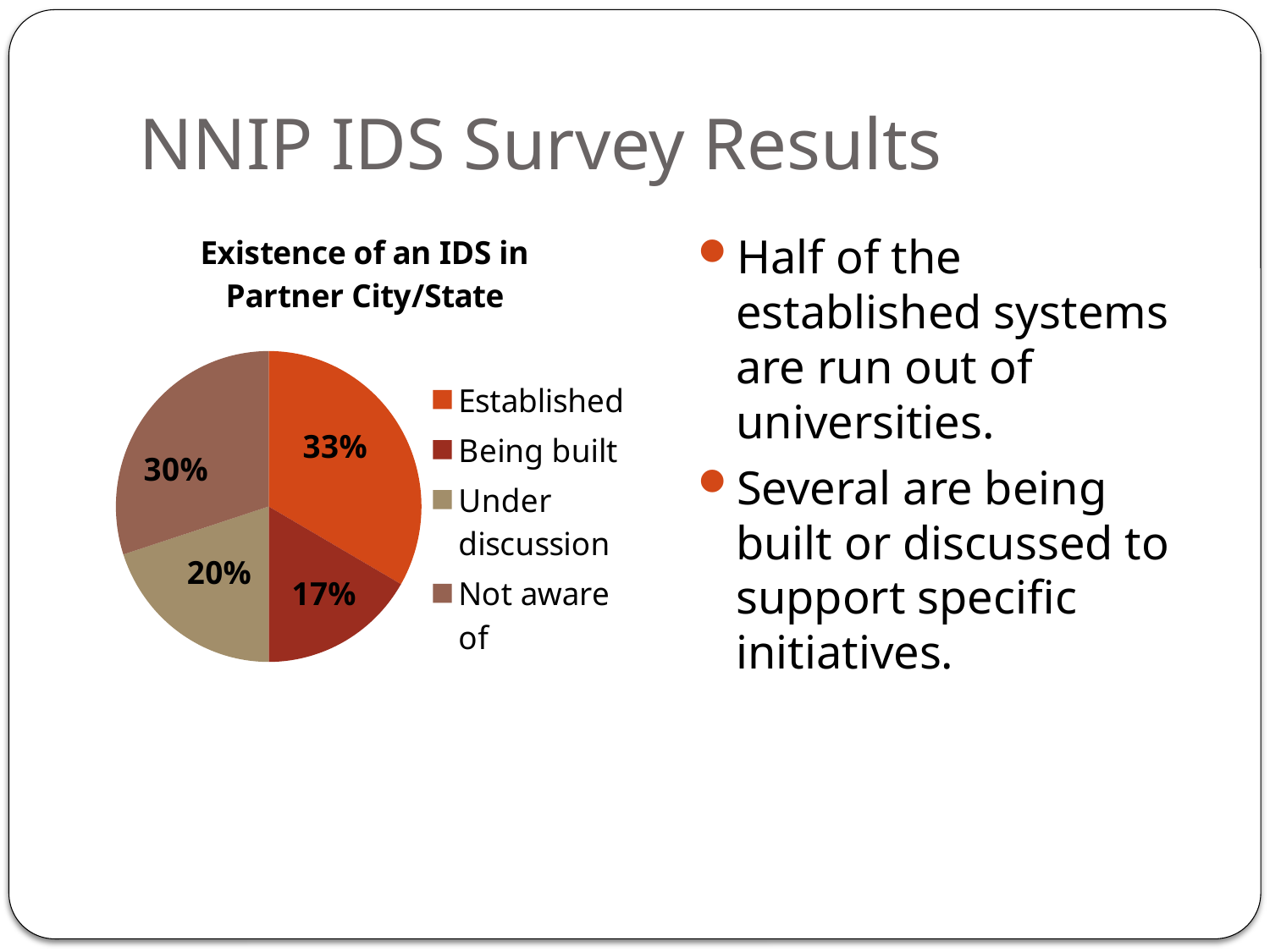
What colour is the Established slice in the pie chart? orange What share of the pie is labelled Under discussion? 20% Which is larger, the share for Not aware of or the share for Under discussion? Not aware of What share of the pie is labelled Not aware of? 30% How many slices does the pie chart have? 4 What share of the pie is labelled Being built? 17% Which category has the smallest share of the pie? Being built Which category has the largest share of the pie? Established What is the difference in percentage points between Established and Being built? 16 What share of the pie is labelled Established? 33% What kind of chart is shown on the slide? pie chart What is the title of the chart? Existence of an IDS in Partner City/State